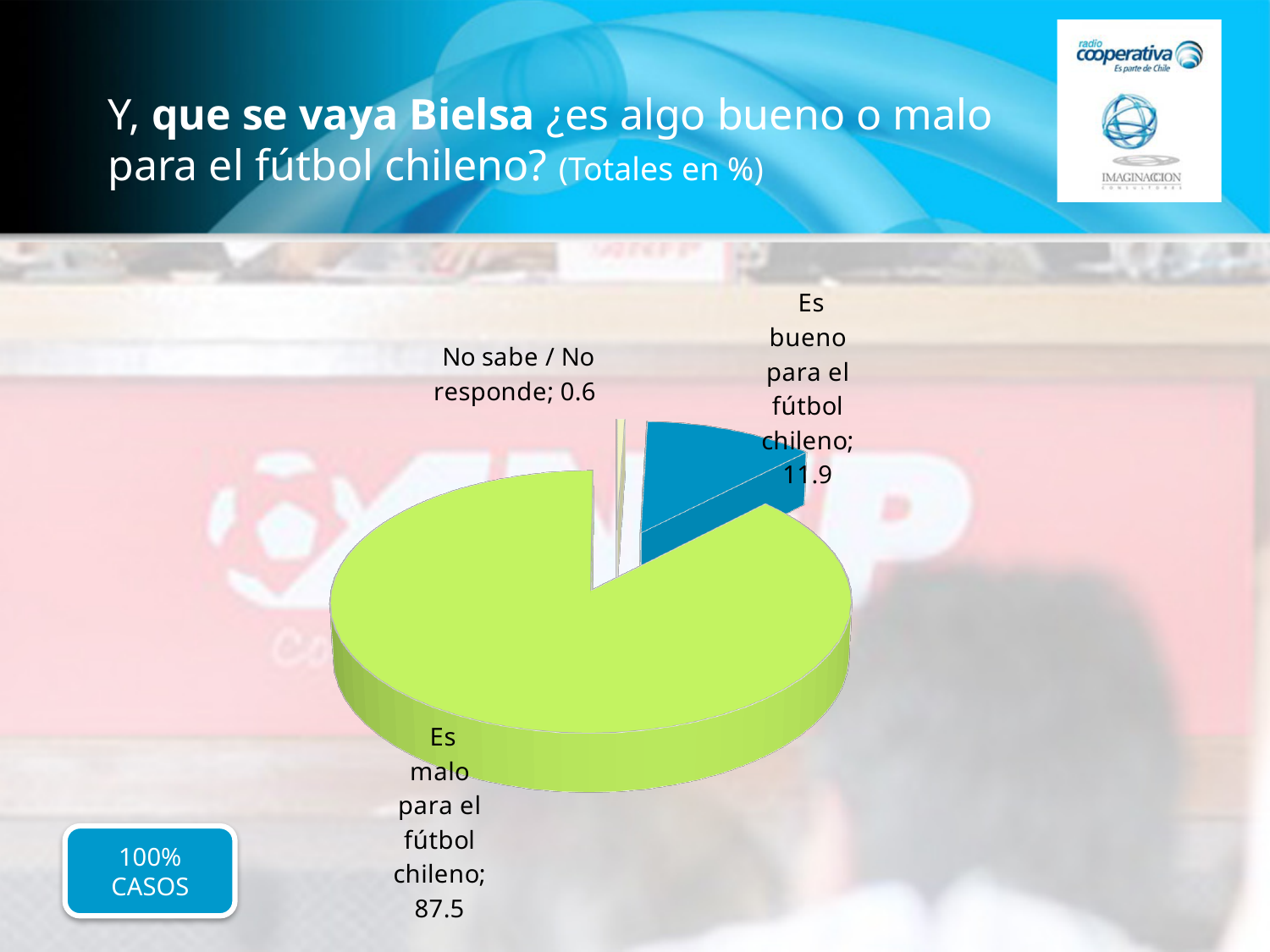
What is the difference between the values for "Es bueno para el fútbol chileno" and "No sabe / No responde"? 11.3 What kind of chart is shown on the slide? Pie chart Which category has the largest slice of the pie? Es malo para el fútbol chileno In what unit are the totals in the chart expressed, according to the slide title? % Which is larger, the value for "Es bueno para el fútbol chileno" or the value for "No sabe / No responde"? Es bueno para el fútbol chileno What colour is the slice for "Es bueno para el fútbol chileno"? Blue What is the difference between the values for "Es malo para el fútbol chileno" and "Es bueno para el fútbol chileno"? 75.6 What is the value for "Es malo para el fútbol chileno"? 87.5 Which category has the smallest slice of the pie? No sabe / No responde What is the value for "No sabe / No responde"? 0.6 What is the value for "Es bueno para el fútbol chileno"? 11.9 How many slices does the pie chart have? 3